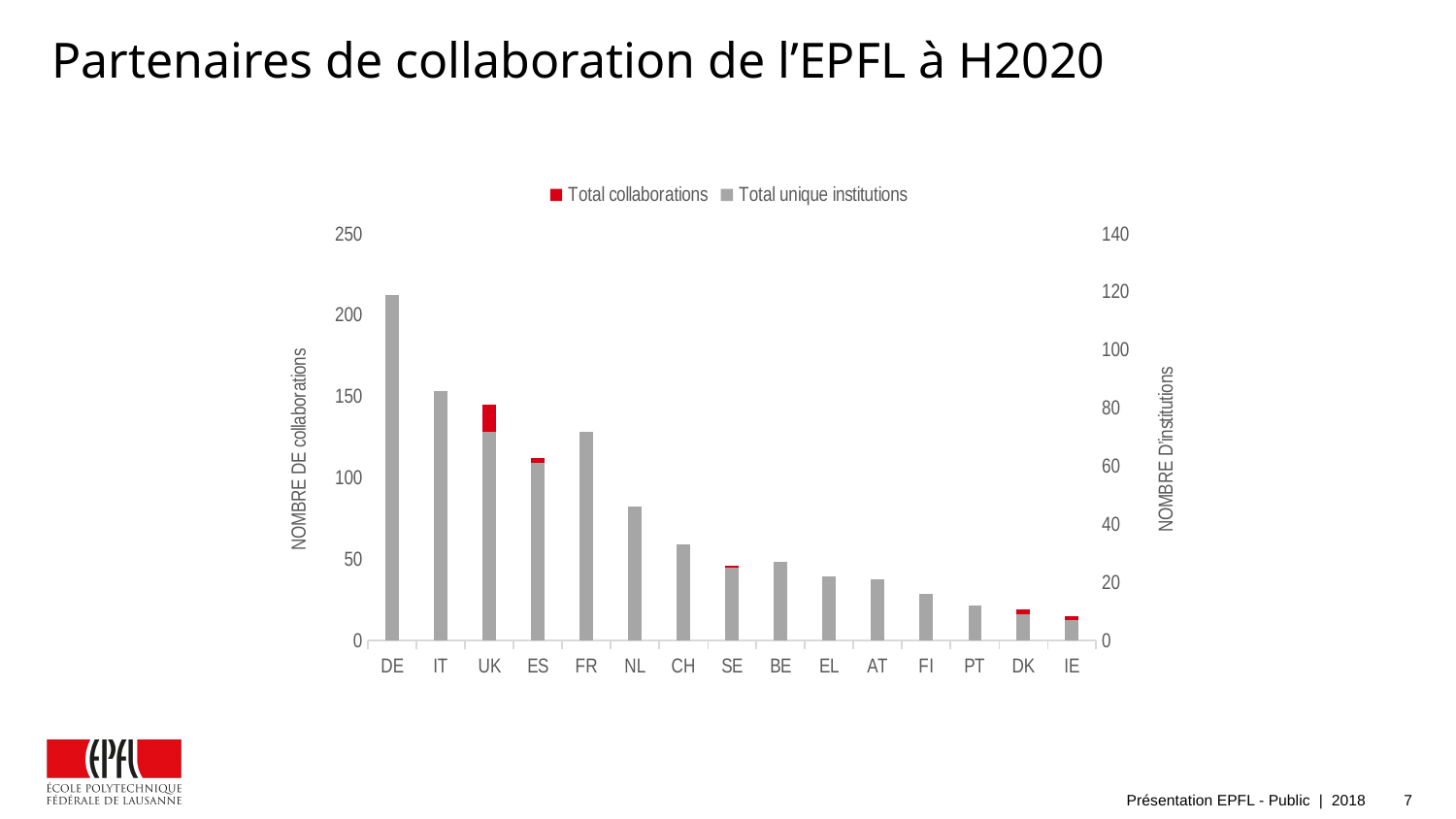
Which country has the shortest grey 'Total unique institutions' bar? IE Which has the taller grey bar, CH or SE? CH What colour are the 'Total collaborations' bars in the chart? red Do the grey bars generally rise or fall from DE on the left to IE on the right? fall What kind of chart is shown on the slide? bar chart How many countries are shown on the x axis of the chart? 15 How many series does the chart legend list? 2 Which has the taller grey bar, DE or IT? DE Which has the taller grey bar, FR or NL? FR Which country has the tallest grey 'Total unique institutions' bar? DE What is the title of the slide containing the chart? Partenaires de collaboration de l’EPFL à H2020